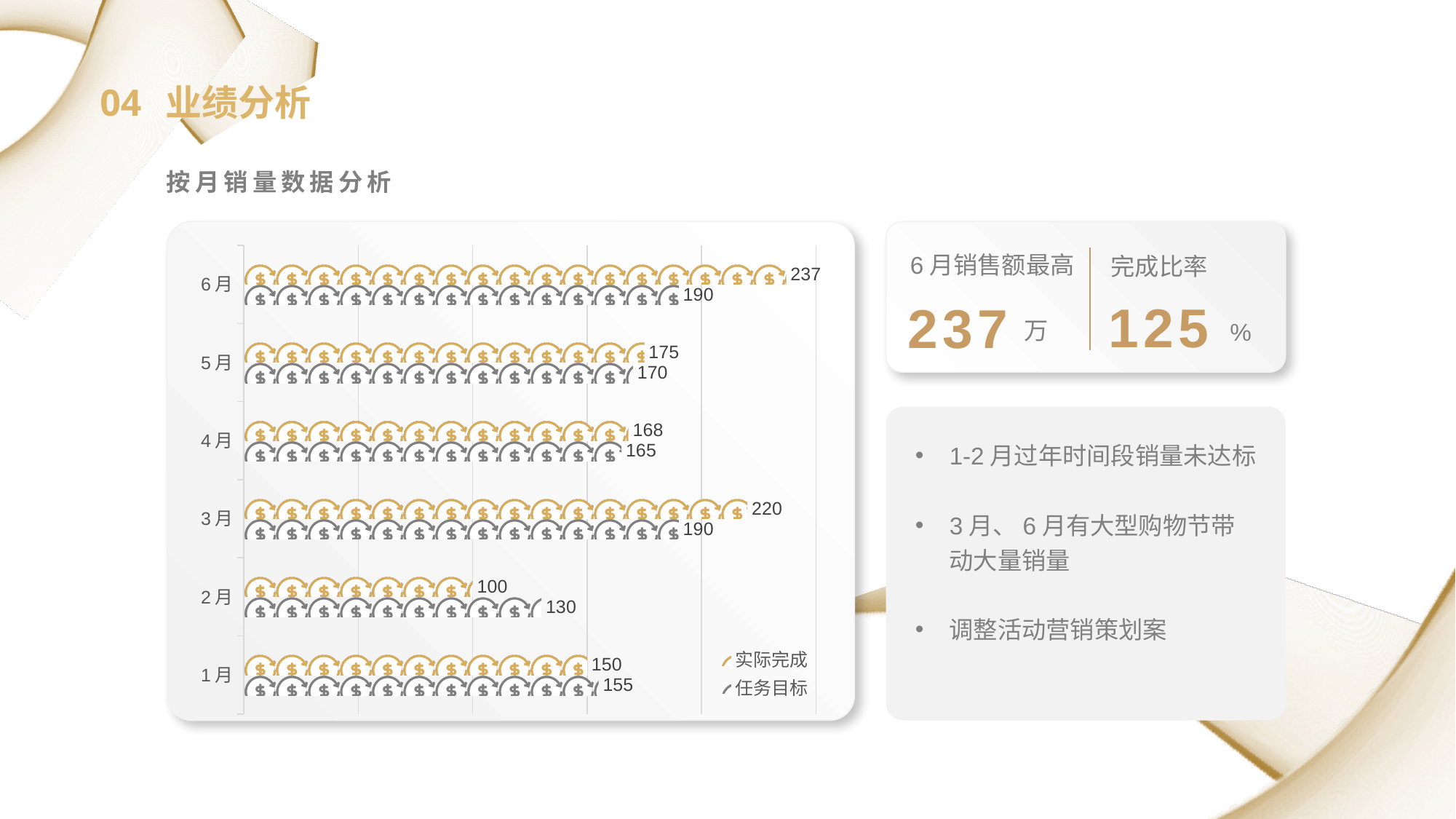
Which month has the highest 实际完成 value? 6月 What is the 实际完成 value for 3月? 220 How many series does the legend list? 2 Which is larger for 1月, 实际完成 or 任务目标? 任务目标 What is the difference between 实际完成 and 任务目标 for 6月? 47 What is the 任务目标 value for 1月? 155 What is the 实际完成 value for 6月? 237 How many months are shown on the chart? 6 Which month has the lowest 实际完成 value? 2月 What type of chart is shown on the slide? bar chart What is the 任务目标 value for 2月? 130 What is the difference between 任务目标 and 实际完成 for 2月? 30